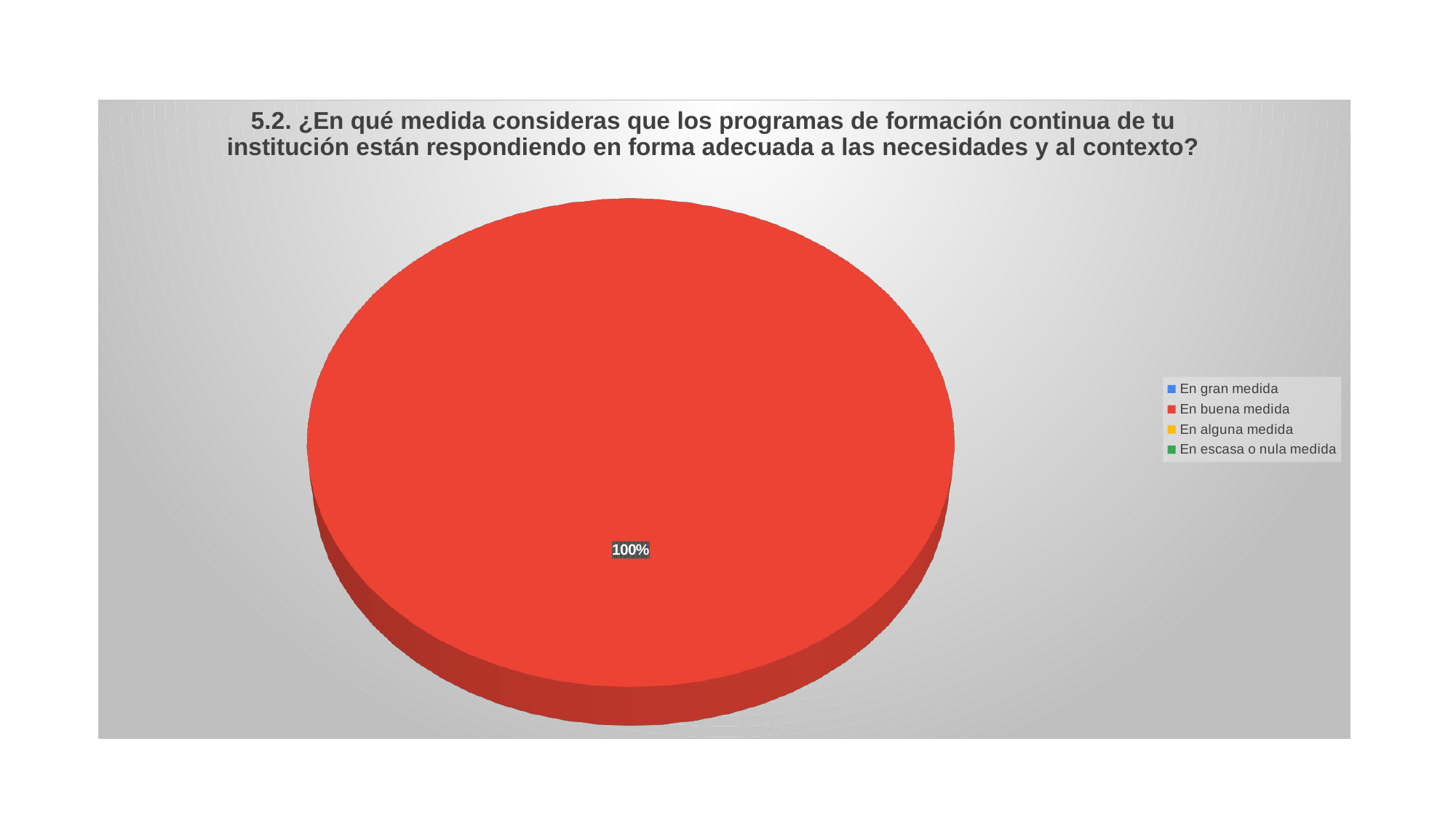
Which category has the largest share of the pie? En buena medida How many entries does the legend list? 4 What kind of chart is shown on the slide? Pie chart Is the share for "En buena medida" greater or less than 50%? greater How many slices are visible in the pie? 1 What is the data label printed on the pie? 100% What share of the pie does "En buena medida" take? 100% Which legend entry is shown in red? En buena medida What is the first entry listed in the legend? En gran medida Which is larger, the share for "En buena medida" or the share for "En gran medida"? En buena medida